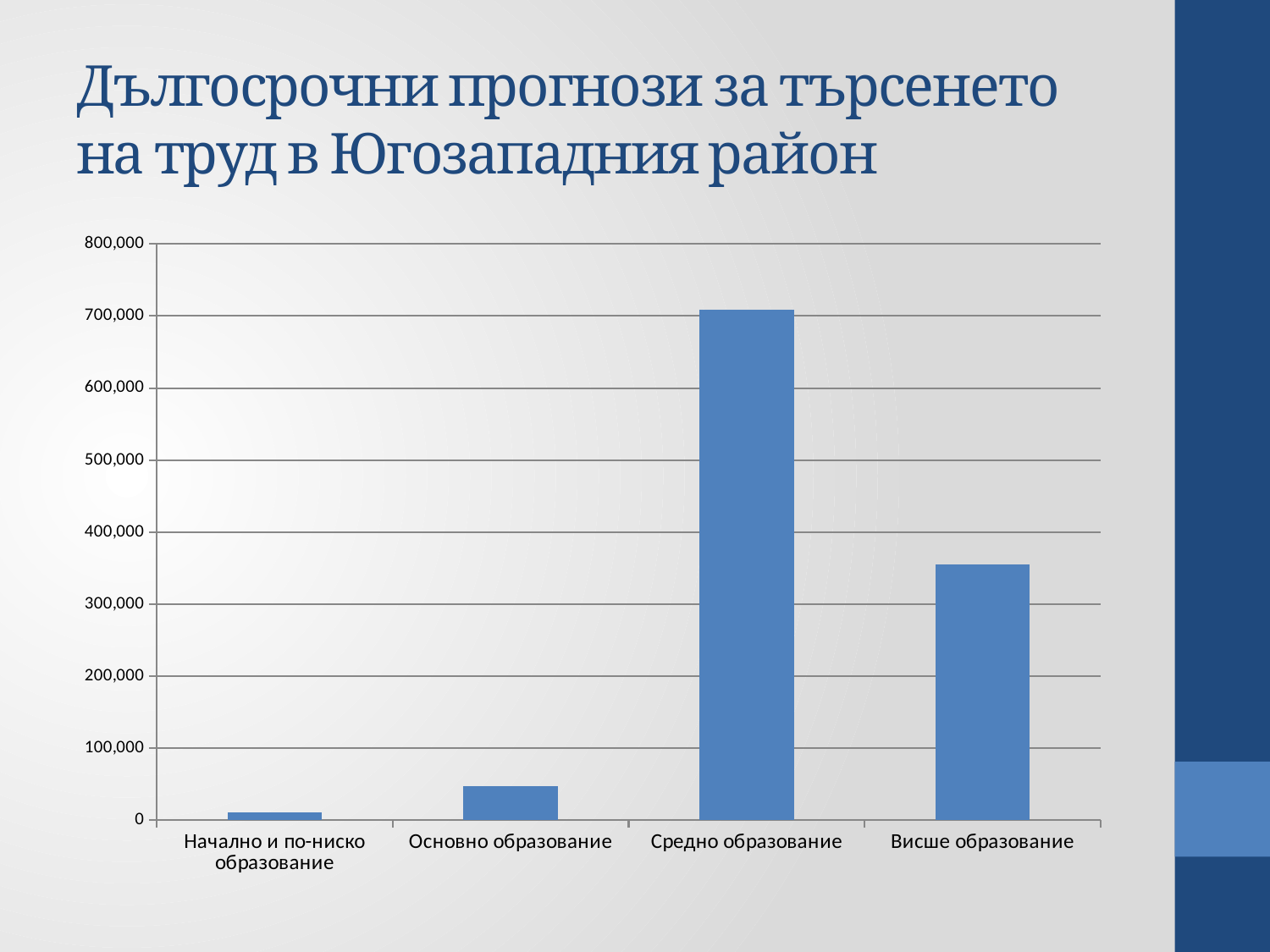
Which is larger: the value for Висше образование or the value for Основно образование? Висше образование Is the value for Висше образование greater or less than 300,000? greater Is the value for Висше образование greater or less than 400,000? less What is the title of the slide containing the chart? Дългосрочни прогнози за търсенето на труд в Югозападния район Is the value for Основно образование greater or less than 100,000? less How many categories are shown on the x axis of the chart? 4 Which category has the highest value in the chart? Средно образование What kind of chart is shown on the slide? bar chart Which category has the lowest value in the chart? Начално и по-ниско образование What is the highest value shown on the vertical axis of the chart? 800,000 Which is larger: the value for Средно образование or the value for Висше образование? Средно образование